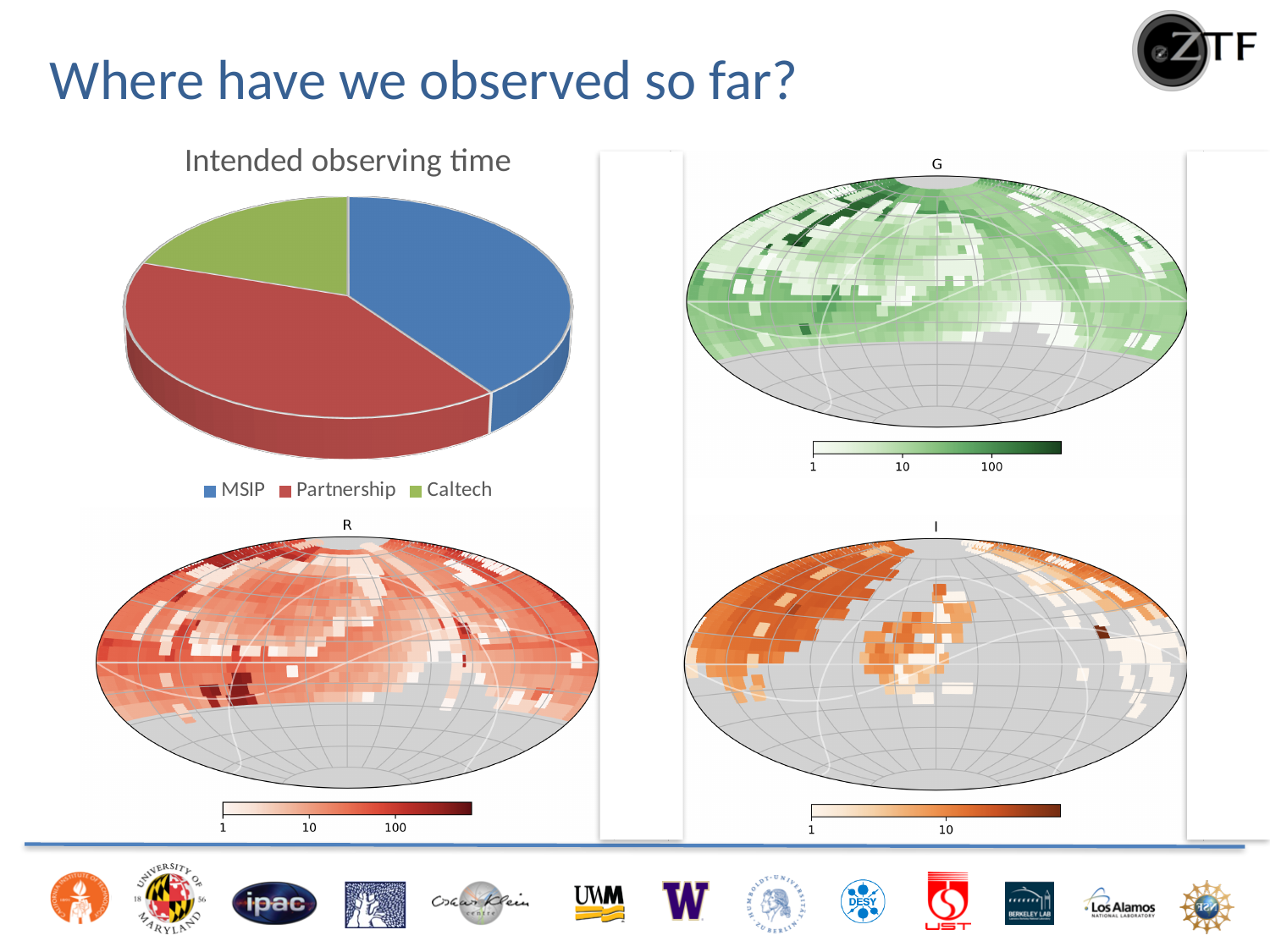
In the "Intended observing time" pie chart, which category has the smallest share? Caltech How many entries does the legend of the "Intended observing time" pie chart list? 3 In the "Intended observing time" pie chart, which is larger, the Partnership slice or the Caltech slice? Partnership In the "Intended observing time" pie chart, which colour represents MSIP? blue In the "Intended observing time" pie chart, which is larger, the MSIP slice or the Caltech slice? MSIP What kind of chart is the "Intended observing time" chart? pie chart What is the title of the pie chart on the slide? Intended observing time How many slices does the "Intended observing time" pie chart have? 3